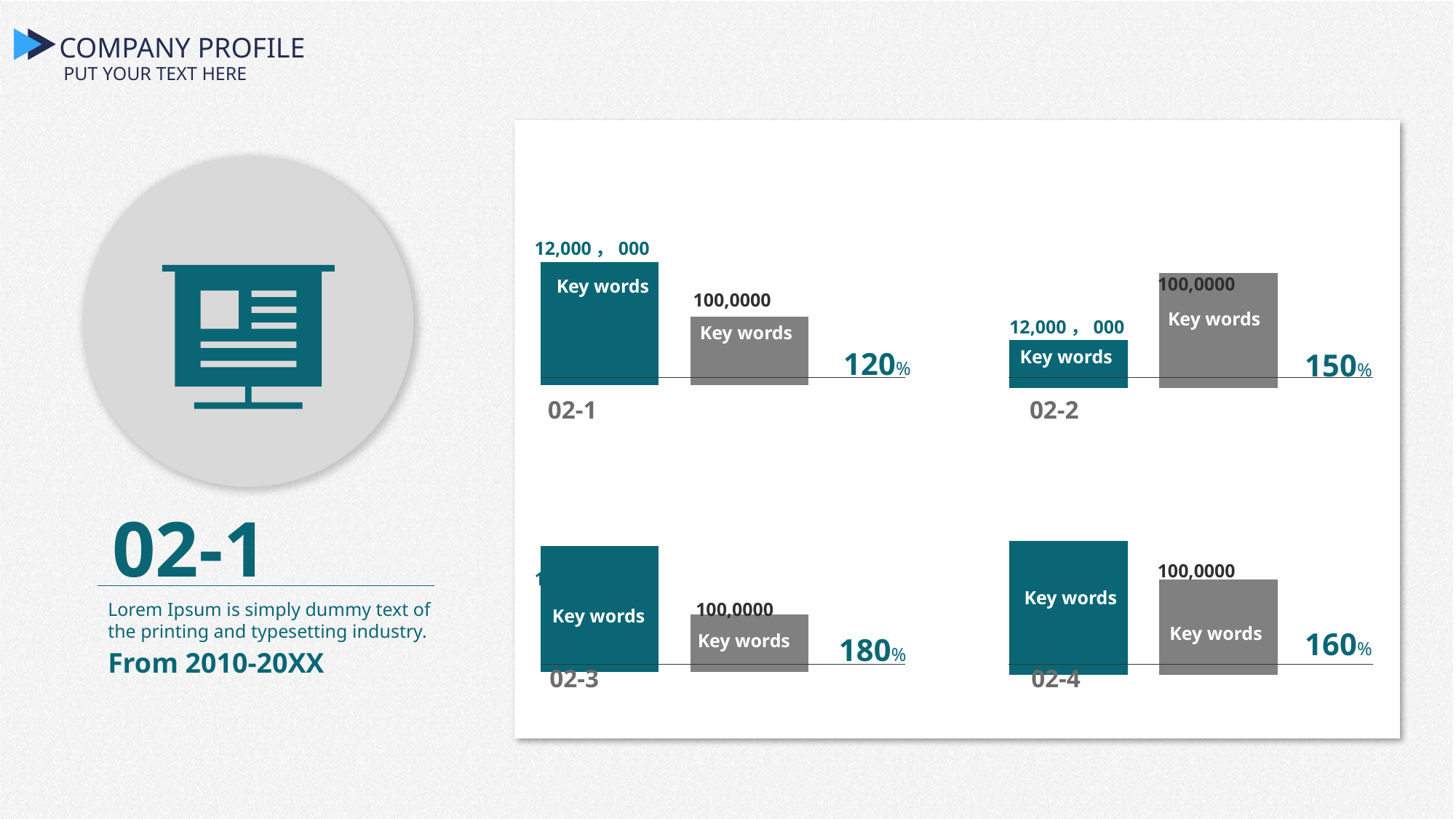
How many small charts are shown in the white panel on the right of the slide? 4 What percentage is shown for the chart labelled 02-2? 150% Which of the four charts (02-1, 02-2, 02-3, 02-4) shows the highest percentage? 02-3 Is the percentage shown for chart 02-2 larger or smaller than the percentage shown for chart 02-4? smaller Which of the four charts (02-1, 02-2, 02-3, 02-4) shows the lowest percentage? 02-1 What kind of chart is the chart labelled 02-4? bar chart What is the difference between the percentage shown for chart 02-3 and the percentage shown for chart 02-1? 60% What percentage is shown for the chart labelled 02-3? 180% What percentage is shown for the chart labelled 02-1? 120% In the chart labelled 02-2, which bar is taller, the teal bar or the grey bar? the grey bar In the chart labelled 02-1, which bar is taller, the teal bar or the grey bar? the teal bar What percentage is shown for the chart labelled 02-4? 160%